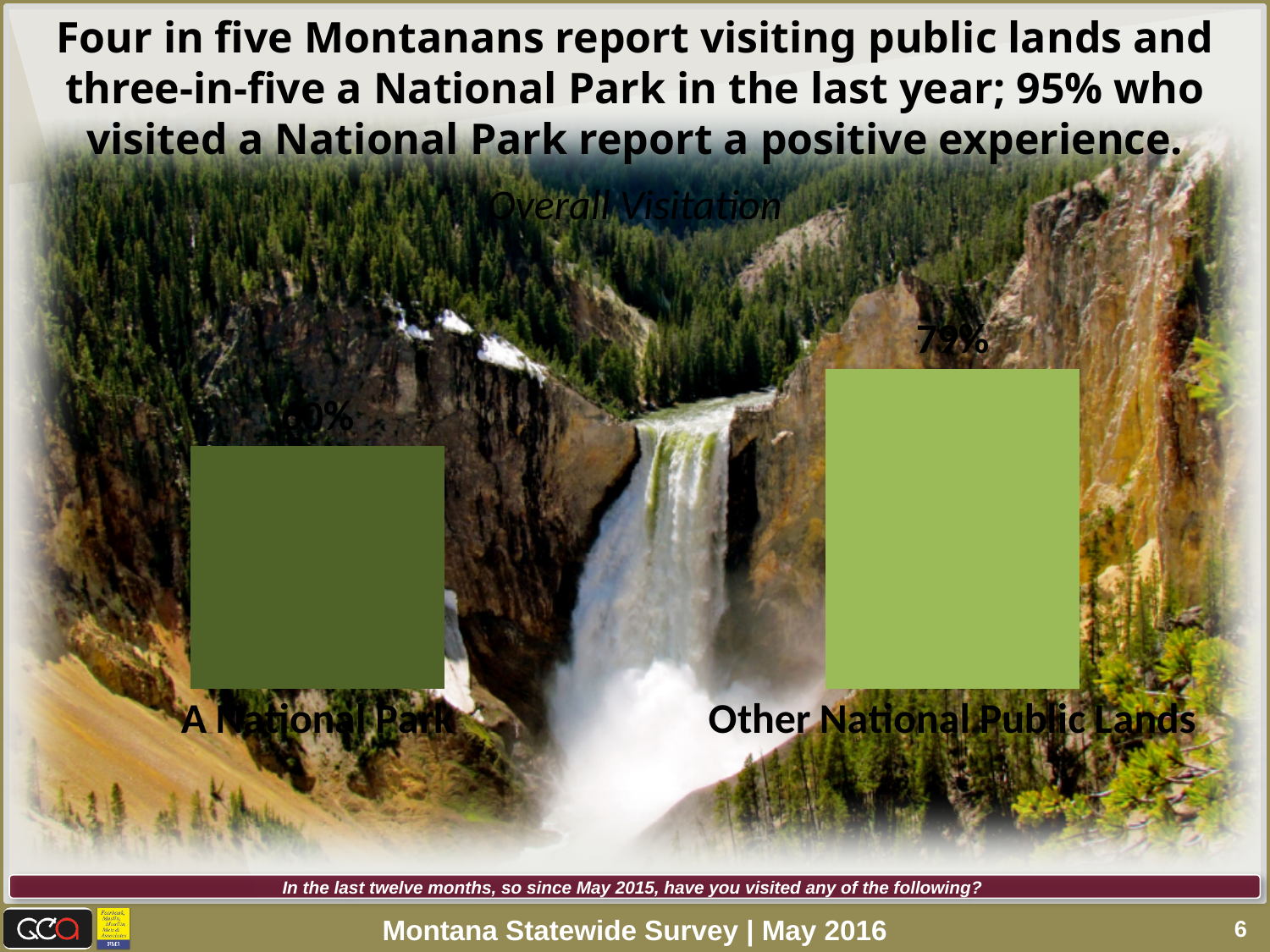
What survey question is the chart based on, as shown at the bottom of the slide? In the last twelve months, so since May 2015, have you visited any of the following? What is the title of the chart? Overall Visitation What is the value for Other National Public Lands? 79% Which is larger, the value for A National Park or the value for Other National Public Lands? Other National Public Lands What is the difference between the value for Other National Public Lands and the value for A National Park? 19 percentage points How many categories does the chart show? 2 Which category has the lowest value? A National Park What is the value for A National Park? 60% Which category has the highest value? Other National Public Lands What kind of chart is shown on the slide? bar chart